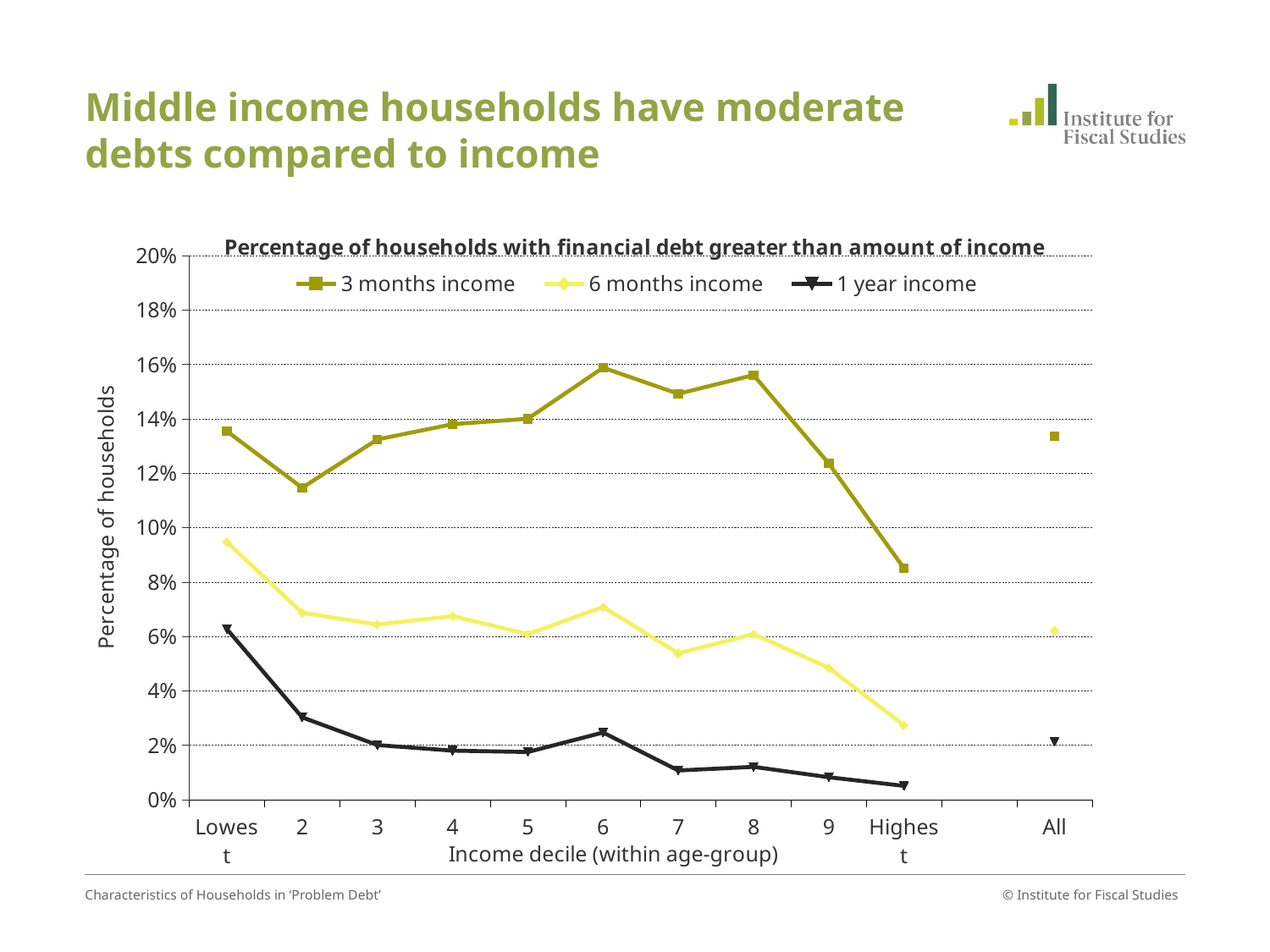
Does the '1 year income' series generally rise or fall from the Lowest decile to the Highest decile? fall Is the '3 months income' value for the Highest decile greater or less than 10%? less For the '3 months income' series, which is larger: the value for the Lowest decile or the value for decile 2? Lowest For the '6 months income' series, which income decile has the highest value? Lowest Is the '3 months income' value for decile 6 greater or less than 14%? greater For the '1 year income' series, which income decile has the highest value? Lowest What kind of chart is shown on the slide? line chart How many series does the legend list? 3 For the '3 months income' series, which income decile has the lowest value? Highest Is the '1 year income' value for decile 2 greater or less than 4%? less How many categories are shown along the x axis (including 'All')? 11 What is the title of the chart? Percentage of households with financial debt greater than amount of income